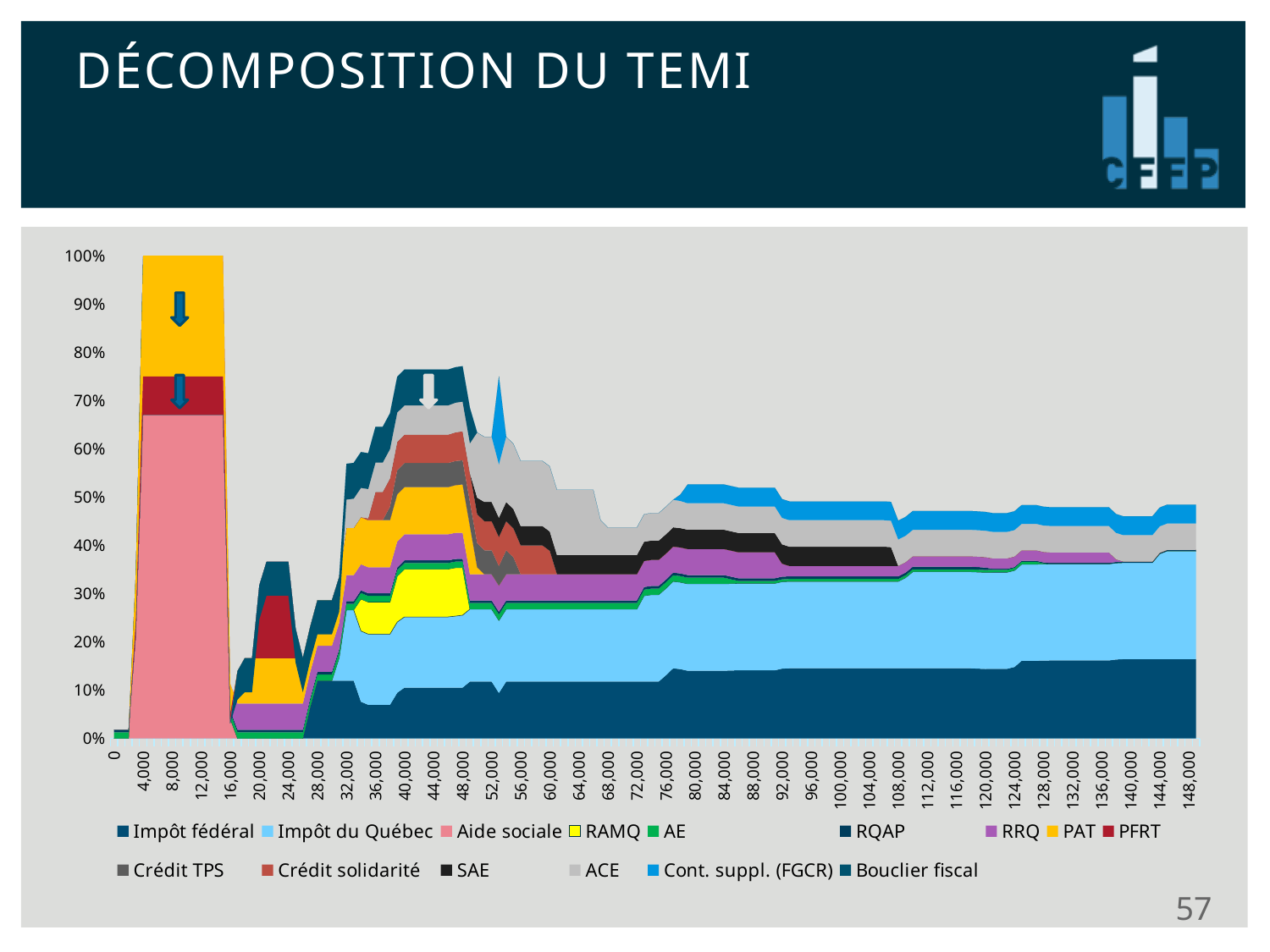
How many series does the legend list? 15 Is the total stacked value at an income of 148,000 greater or less than 60%? less Is the total stacked value at an income of 40,000 greater or less than 70%? greater What is the title of the slide containing the chart? DÉCOMPOSITION DU TEMI What kind of chart is shown on the slide? Area chart Which colour represents the 'Aide sociale' series in the chart? Pink Is the total stacked value at an income of 28,000 greater or less than 50%? less Is the total stacked value larger at an income of 40,000 or at an income of 100,000? 40,000 Is the total stacked value larger at an income of 8,000 or at an income of 148,000? 8,000